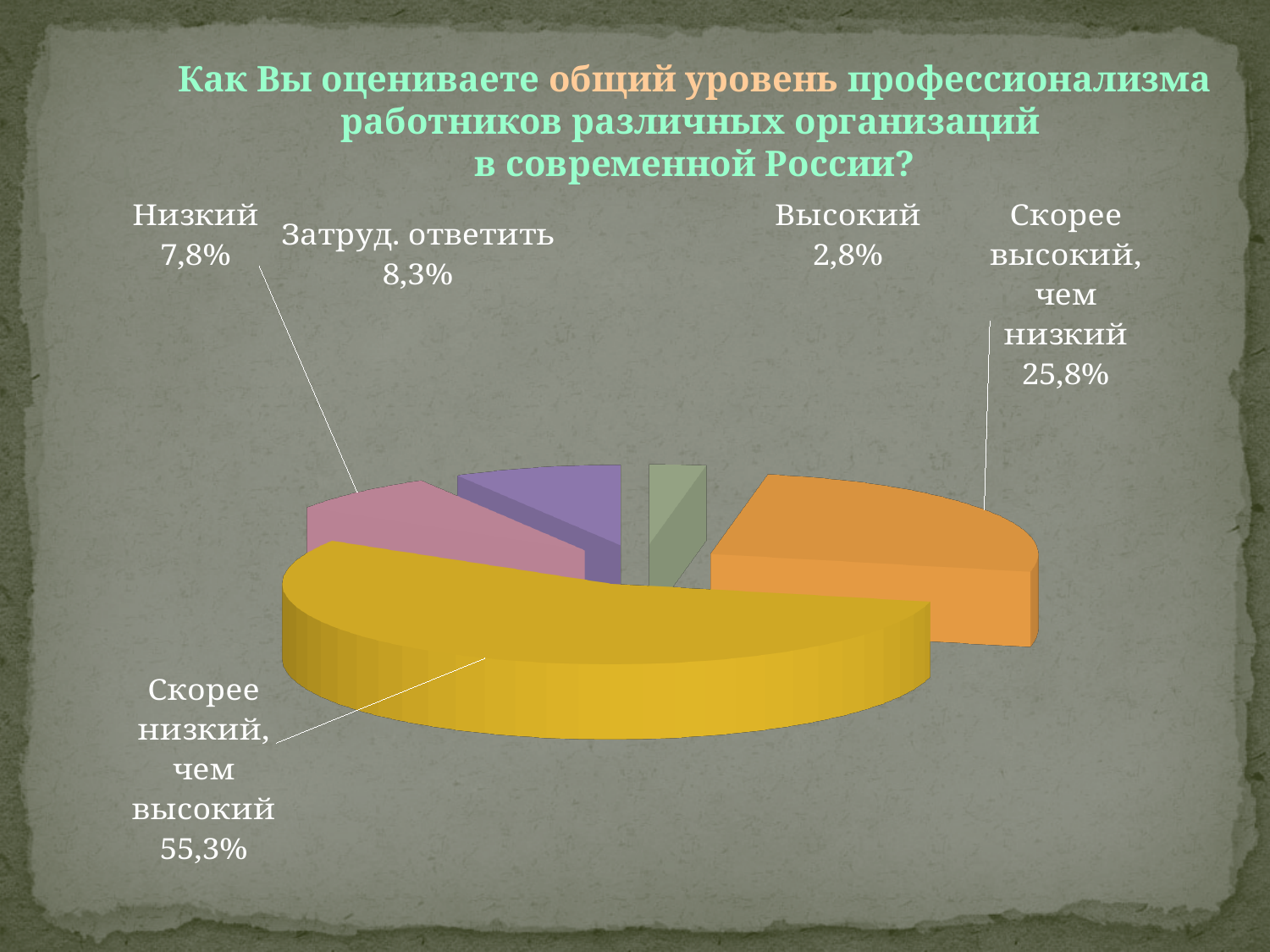
What is the difference between "Затруд. ответить" and "Низкий"? 0,5% What share of respondents answered "Скорее низкий, чем высокий"? 55,3% Which is larger: the share for "Низкий" or the share for "Затруд. ответить"? Затруд. ответить What percentage of respondents chose "Затруд. ответить"? 8,3% How many percentage points larger is "Скорее низкий, чем высокий" than "Скорее высокий, чем низкий"? 29,5% What percentage is shown for "Скорее высокий, чем низкий"? 25,8% How many answer options (slices) does the pie chart show? 5 Which answer option has the largest share of the pie? Скорее низкий, чем высокий Which answer option has the smallest share of the pie? Высокий What value is shown for the "Высокий" slice? 2,8% What type of chart is shown on the slide? Pie chart What value is shown for "Низкий"? 7,8%